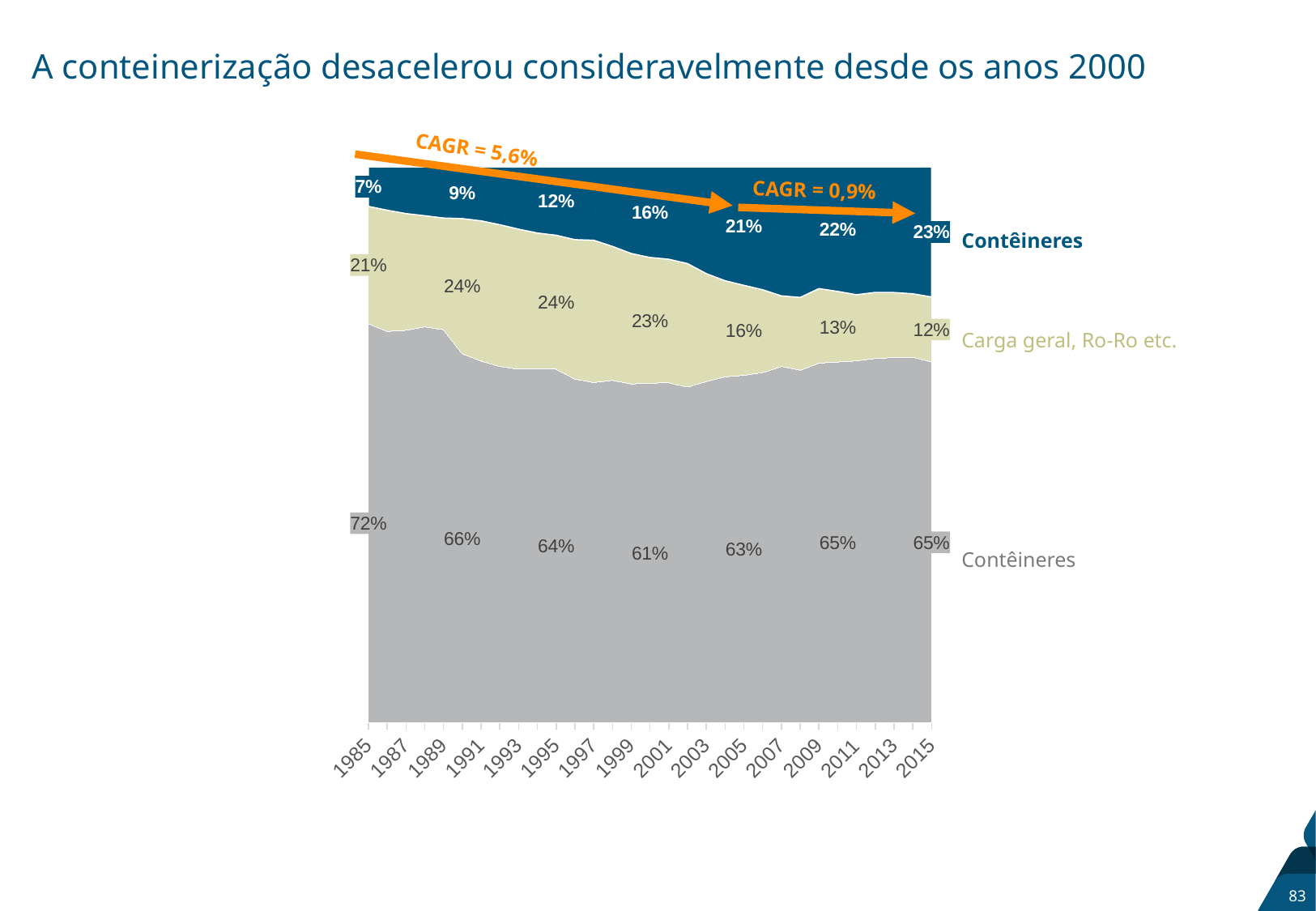
How many series are stacked in the chart? 3 What share does the 'Carga geral, Ro-Ro etc.' series have in 1985? 21% Does the share of the dark blue Contêineres series (top) rise or fall from 1985 to 2015? Rise What share does the 'Carga geral, Ro-Ro etc.' series have in 2015? 12% Does the share of 'Carga geral, Ro-Ro etc.' rise or fall from 1985 to 2015? Fall What share does the grey series at the bottom of the chart have in 1985? 72% What share does the dark blue Contêineres series (top) have in 1985? 7% What kind of chart is shown on the slide? Stacked area chart What share does the dark blue Contêineres series (top) have in 2015? 23% What are the two CAGR values annotated on the chart? 5,6% and 0,9% What share does the dark blue Contêineres series (top) have in 2005? 21% By how many percentage points did the dark blue Contêineres share (top) grow between 1985 and 2015? 16 percentage points